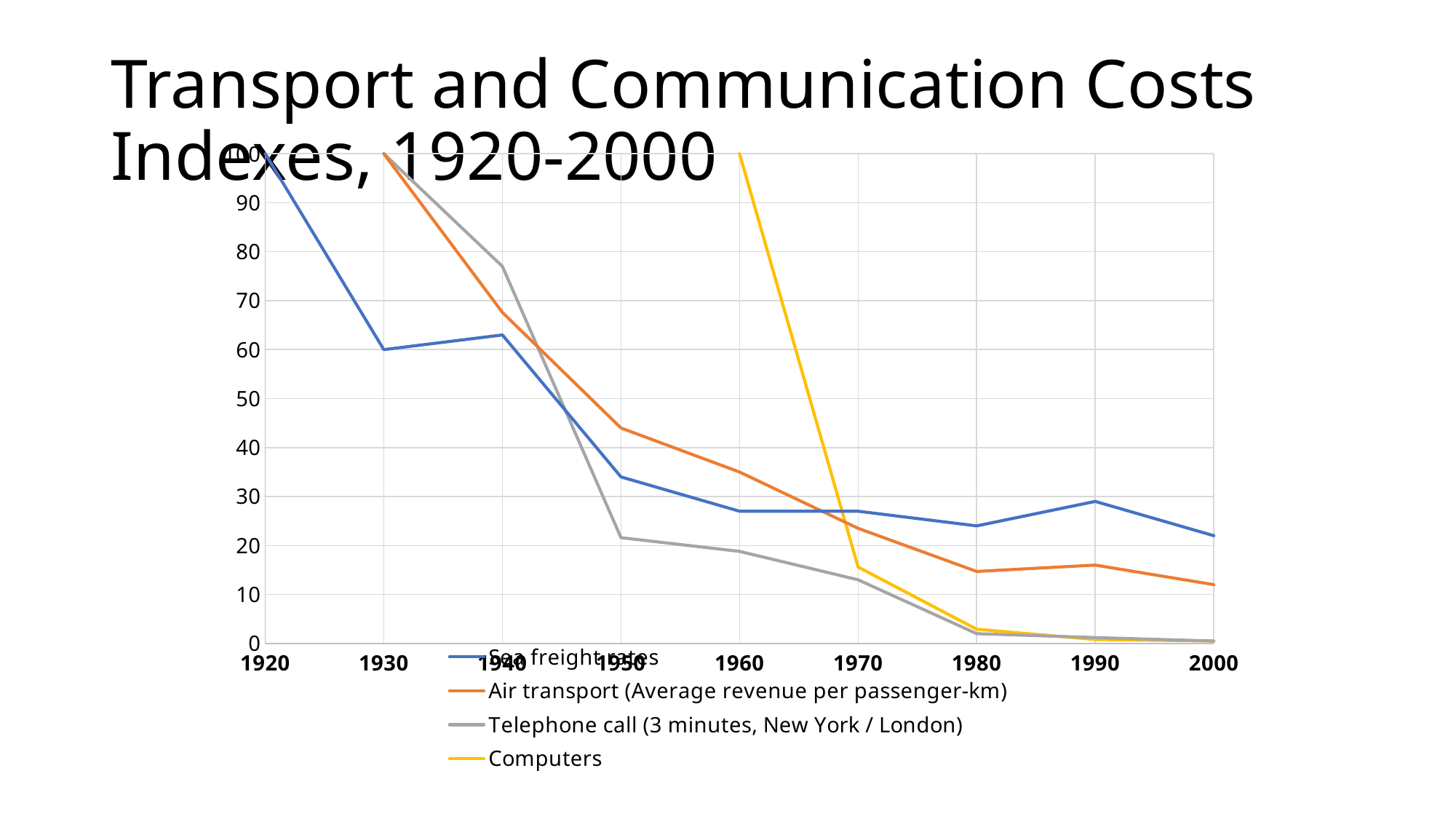
In 2000, which is larger: Sea freight rates or Air transport (Average revenue per passenger-km)? Sea freight rates Is the value for Air transport (Average revenue per passenger-km) in 1940 greater or less than 60? greater How many years are marked along the x axis? 9 Is the value for Telephone call (3 minutes, New York / London) in 1950 greater or less than 30? less Which series has the highest value in 2000? Sea freight rates Do the values for Sea freight rates rise or fall from 1920 to 1950? fall In 1940, which is larger: Telephone call (3 minutes, New York / London) or Sea freight rates? Telephone call (3 minutes, New York / London) Is the value for Sea freight rates in 1950 greater or less than 40? less What is the value for Sea freight rates in 1930? 60 How many series does the legend list? 4 What kind of chart is shown on the slide? line chart